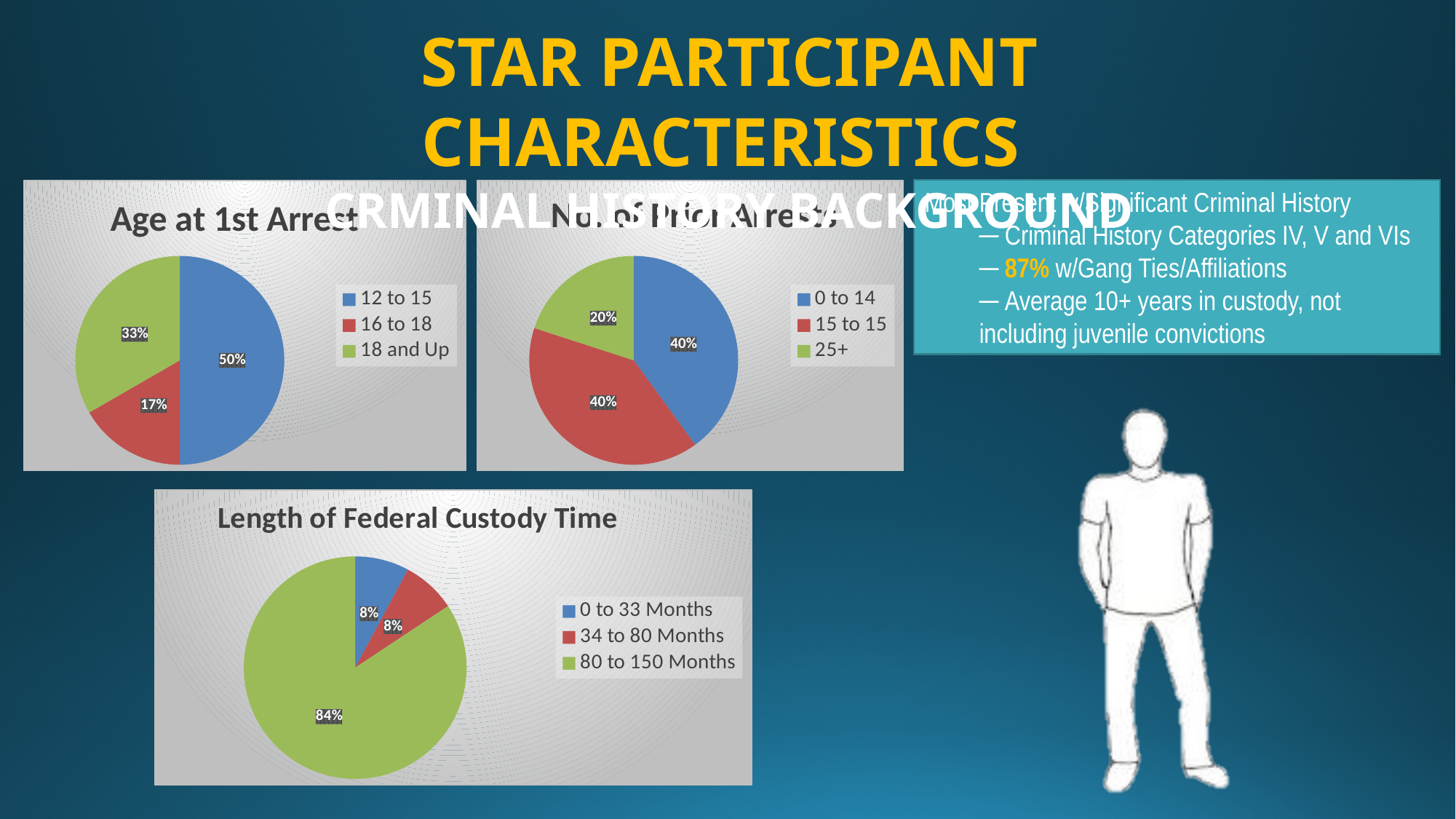
In the 'Length of Federal Custody Time' chart, what percentage is shown for '80 to 150 Months'? 84% In the top middle pie chart (prior arrests), which category has the smallest slice? 25+ In the 'Age at 1st Arrest' chart, what share of participants were 12 to 15 at first arrest? 50% In the 'Length of Federal Custody Time' chart, what colour is the '80 to 150 Months' slice? Green In the 'Age at 1st Arrest' chart, what is the difference in percentage points between the '18 and Up' and '16 to 18' slices? 16 In the 'Age at 1st Arrest' chart, what percentage is shown for the '16 to 18' category? 17% In the top middle pie chart (prior arrests), how many categories does the legend list? 3 In the top middle pie chart (prior arrests), what percentage is shown for the '25+' category? 20% In the 'Length of Federal Custody Time' chart, which category has the largest slice? 80 to 150 Months What type of chart is 'Length of Federal Custody Time'? Pie chart In the 'Age at 1st Arrest' chart, which category has the smallest slice? 16 to 18 In the 'Age at 1st Arrest' chart, which category has the largest slice? 12 to 15